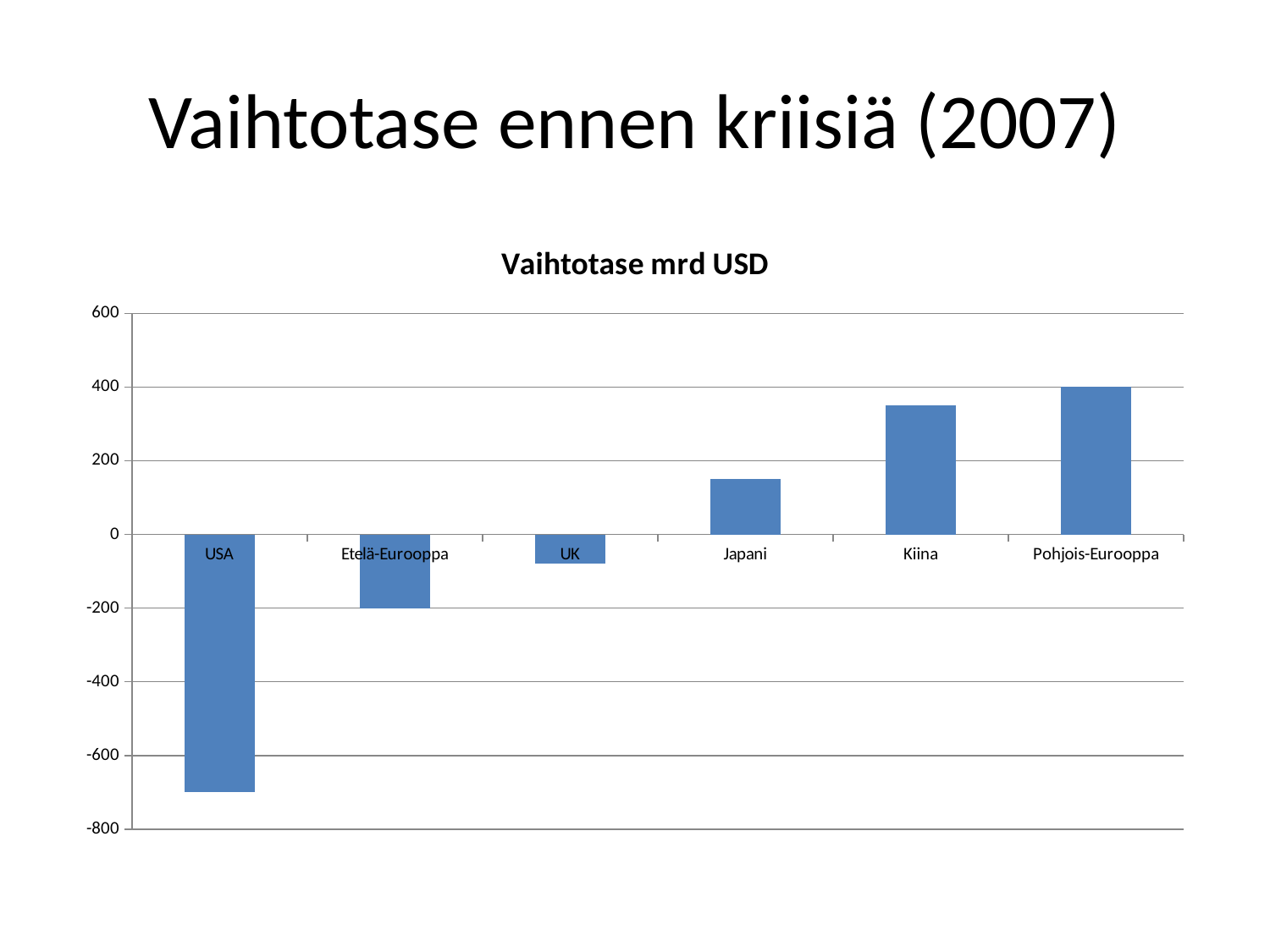
Which category has the highest value in the chart? Pohjois-Eurooppa Which category has the lowest value in the chart? USA Is the value for UK greater or less than 0? less How many categories are shown on the x axis of the chart? 6 Is the value for USA greater or less than -600? less What is the value for Pohjois-Eurooppa? 400 Is the value for Kiina greater or less than 200? greater What is the title of the chart? Vaihtotase mrd USD Which has the larger value, Kiina or Japani? Kiina Which has the lower value, USA or Etelä-Eurooppa? USA What kind of chart is shown on the slide? bar chart